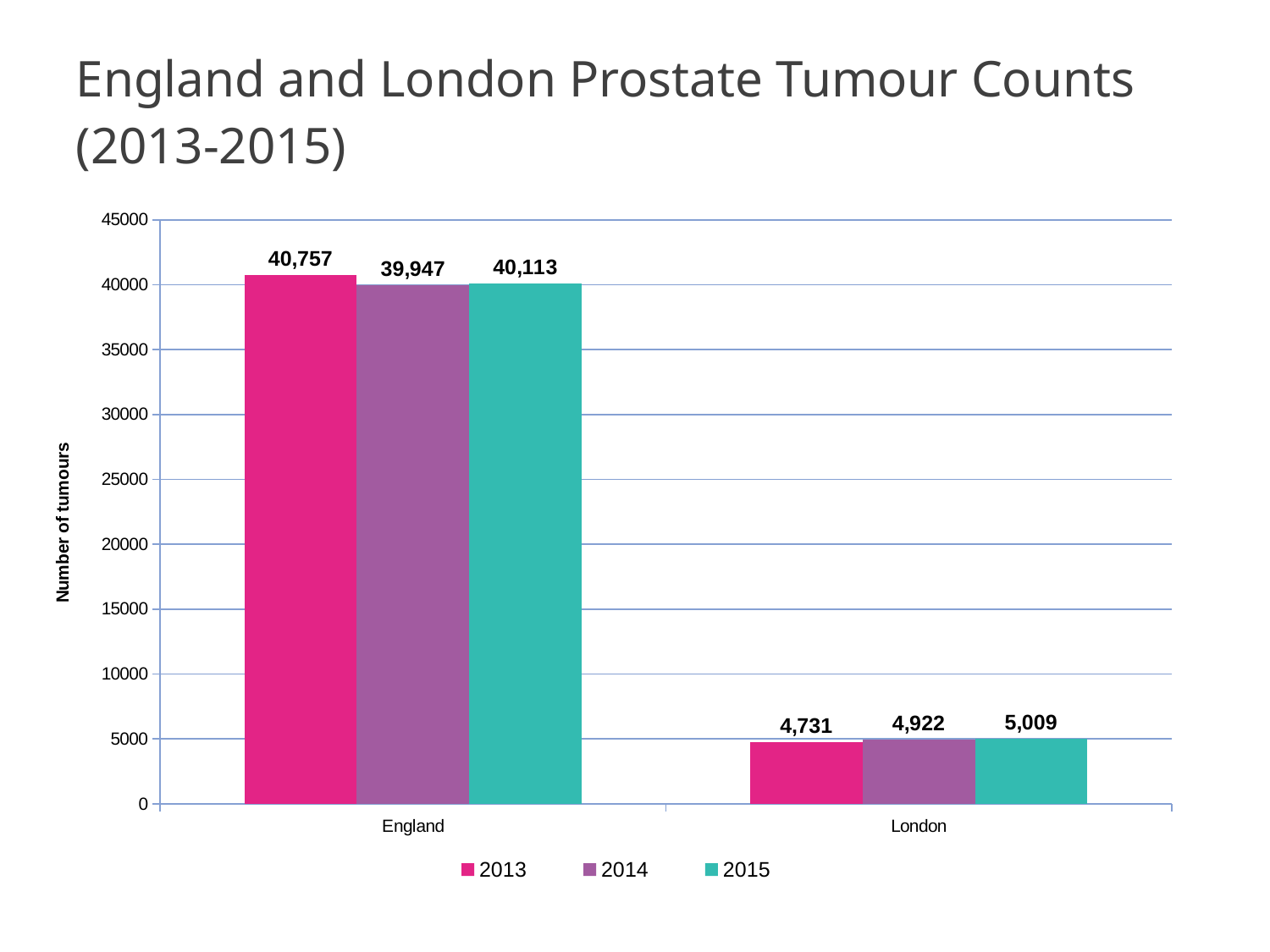
What is the number of prostate tumours in England in 2013? 40,757 Which is larger, the London count in 2014 or the London count in 2015? 2015 Is the value for England in 2015 greater or less than 40000? greater What is the number of prostate tumours in England in 2014? 39,947 Which year has the highest tumour count for England? 2013 What kind of chart is shown on the slide? Bar chart What is the number of prostate tumours in London in 2015? 5,009 What is the difference between the England tumour counts in 2013 and 2014? 810 What is the difference between the London tumour counts in 2015 and 2013? 278 How many series does the legend list? 3 Which year has the lowest tumour count for London? 2013 What is the label on the vertical axis? Number of tumours